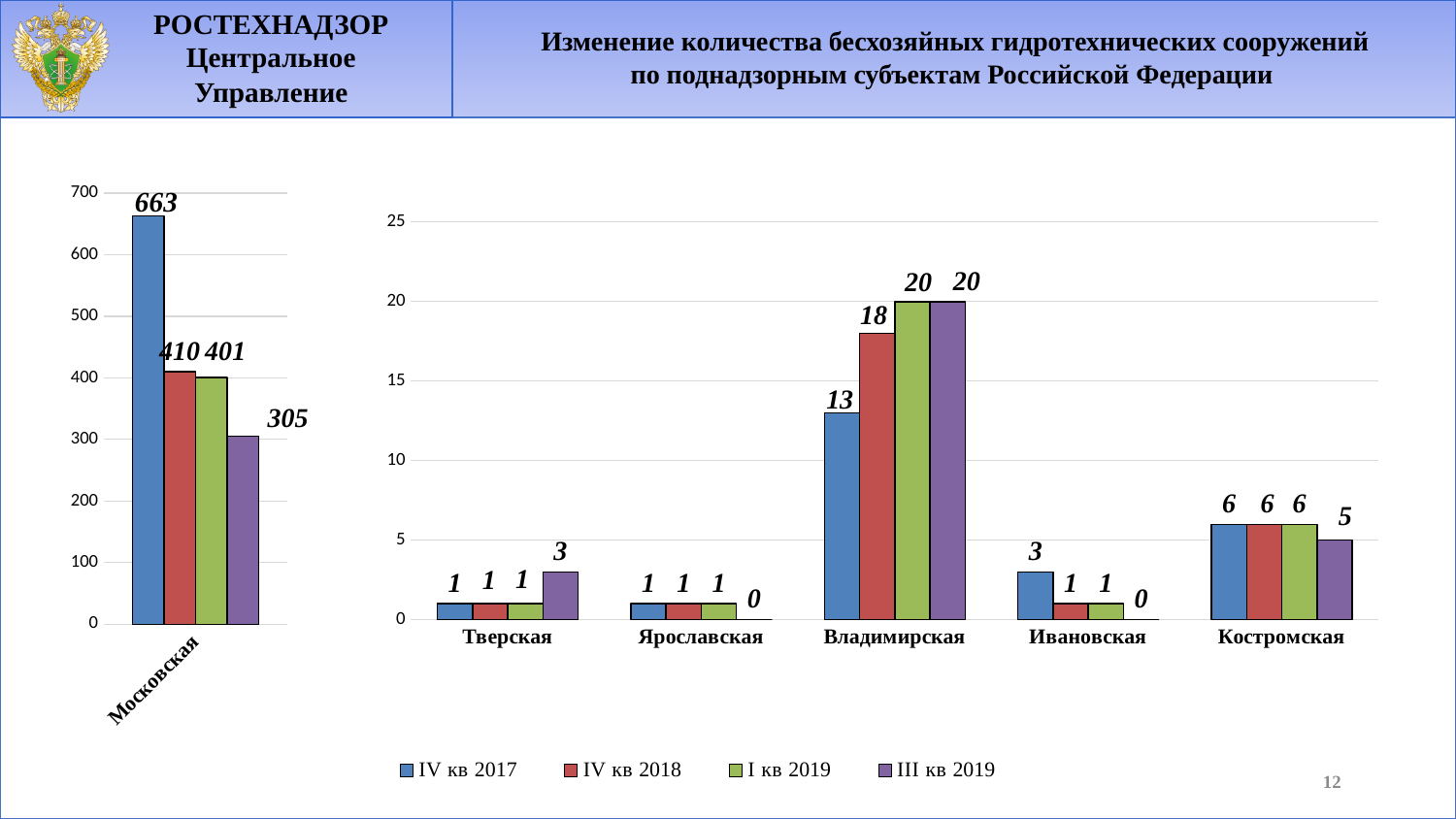
In the right chart, what is the difference between the IV кв 2017 and I кв 2019 values for Владимирская? 7 In the right chart, what is the value for Владимирская in IV кв 2018? 18 How many series does the legend list? 4 What kind of chart is the right chart? bar chart In the left chart, what is the value for Московская in III кв 2019? 305 In the right chart, what is the value for Костромская in III кв 2019? 5 How many categories are shown on the x axis of the right chart? 5 In the left chart, what is the value for Московская in IV кв 2017? 663 In the left chart, what is the difference between the IV кв 2017 and IV кв 2018 values for Московская? 253 In the right chart, which category has the highest value in I кв 2019? Владимирская In the right chart, which category has the lowest value in III кв 2019? Ярославская and Ивановская (both 0) In the right chart, which is larger for Ивановская: the IV кв 2017 value or the III кв 2019 value? IV кв 2017